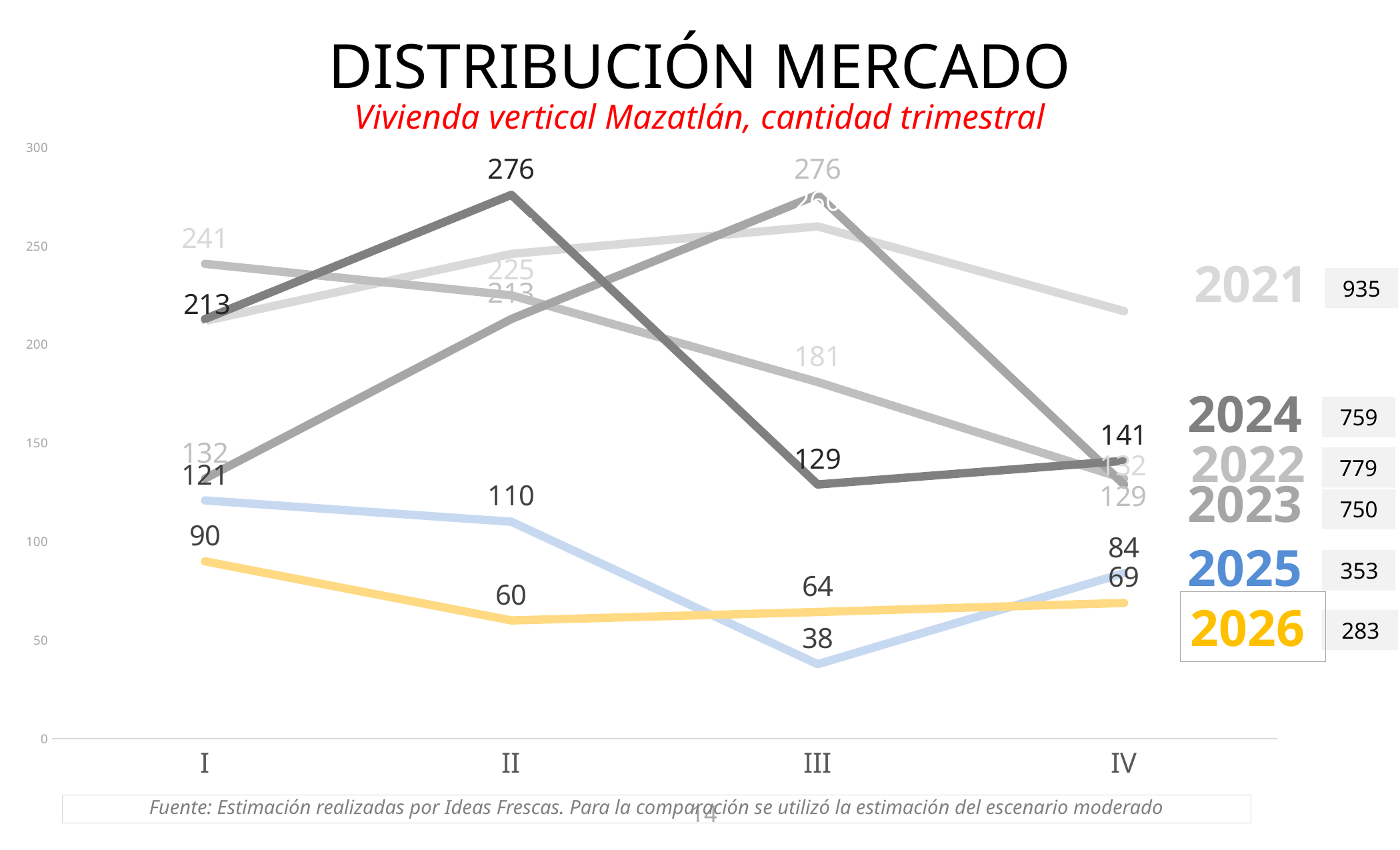
How many series (years) does the legend list? 6 According to the legend, what is the annual total for 2021? 935 What is the difference between the 2024 values in quarter II and quarter III? 147 What is the value for 2024 in quarter II? 276 In which quarter does the 2025 series reach its highest value? I Which year has the highest annual total shown in the legend? 2021 In quarter IV, which series has the larger value, 2025 or 2026? 2025 How many quarters are shown on the x axis? 4 What kind of chart is shown on the slide? Line chart In which quarter does the 2026 series have its lowest value? II What is the value for 2025 in quarter III? 38 What is the value for 2026 in quarter I? 90